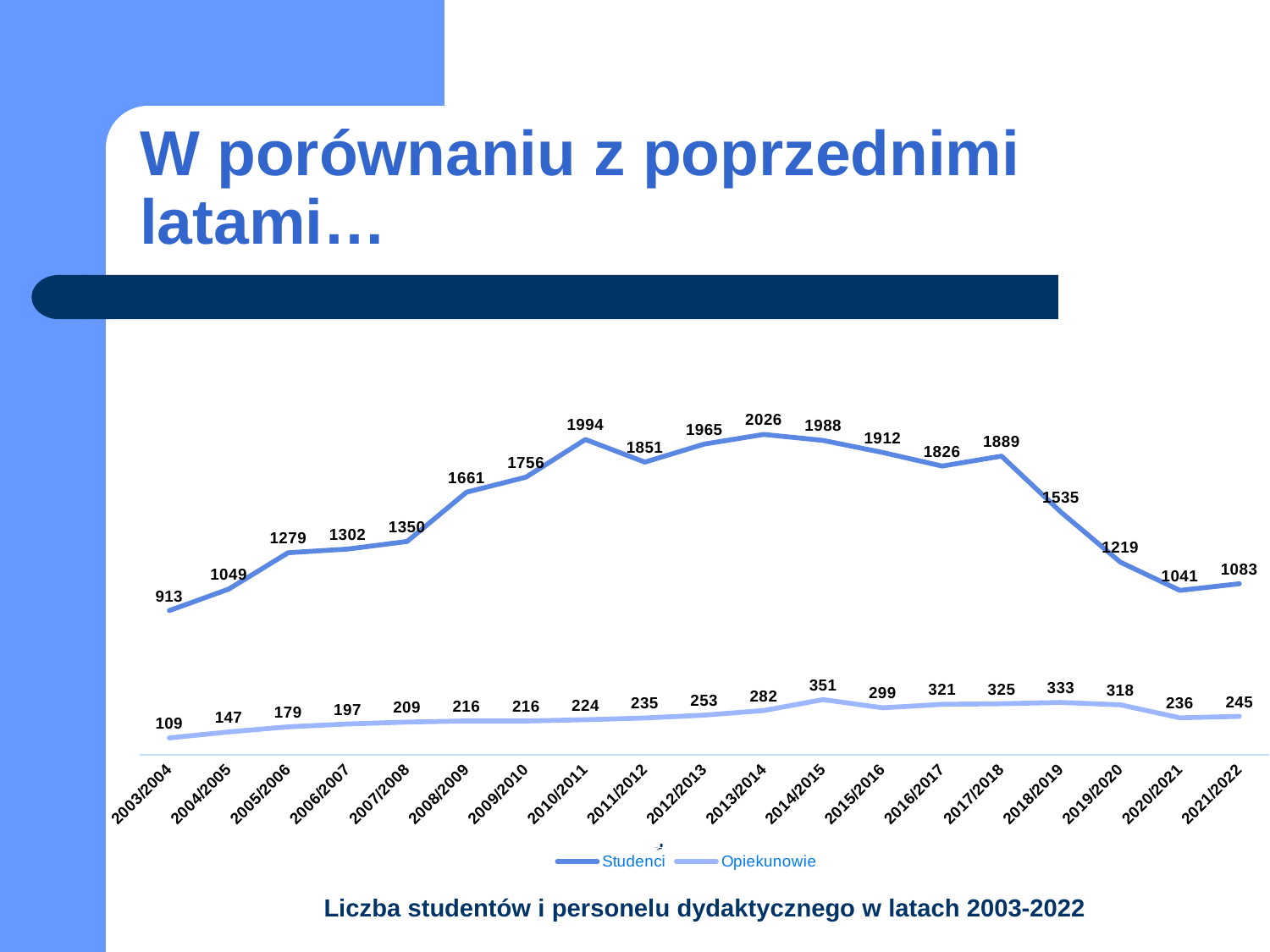
Does the Studenci line rise or fall from 2017/2018 to 2020/2021? Fall In which year is the Opiekunowie value lowest? 2003/2004 What is the value for Studenci in 2010/2011? 1994 What is the value for Opiekunowie in 2014/2015? 351 What is the value for Studenci in 2021/2022? 1083 What is the difference between the Opiekunowie values for 2014/2015 and 2015/2016? 52 What kind of chart is shown on the slide? Line chart How many academic years are plotted on the x axis? 19 How many series does the legend list? 2 What is the difference between the Studenci values for 2013/2014 and 2003/2004? 1113 In which year is the Studenci value highest? 2013/2014 Which year has the larger Studenci value, 2016/2017 or 2017/2018? 2017/2018